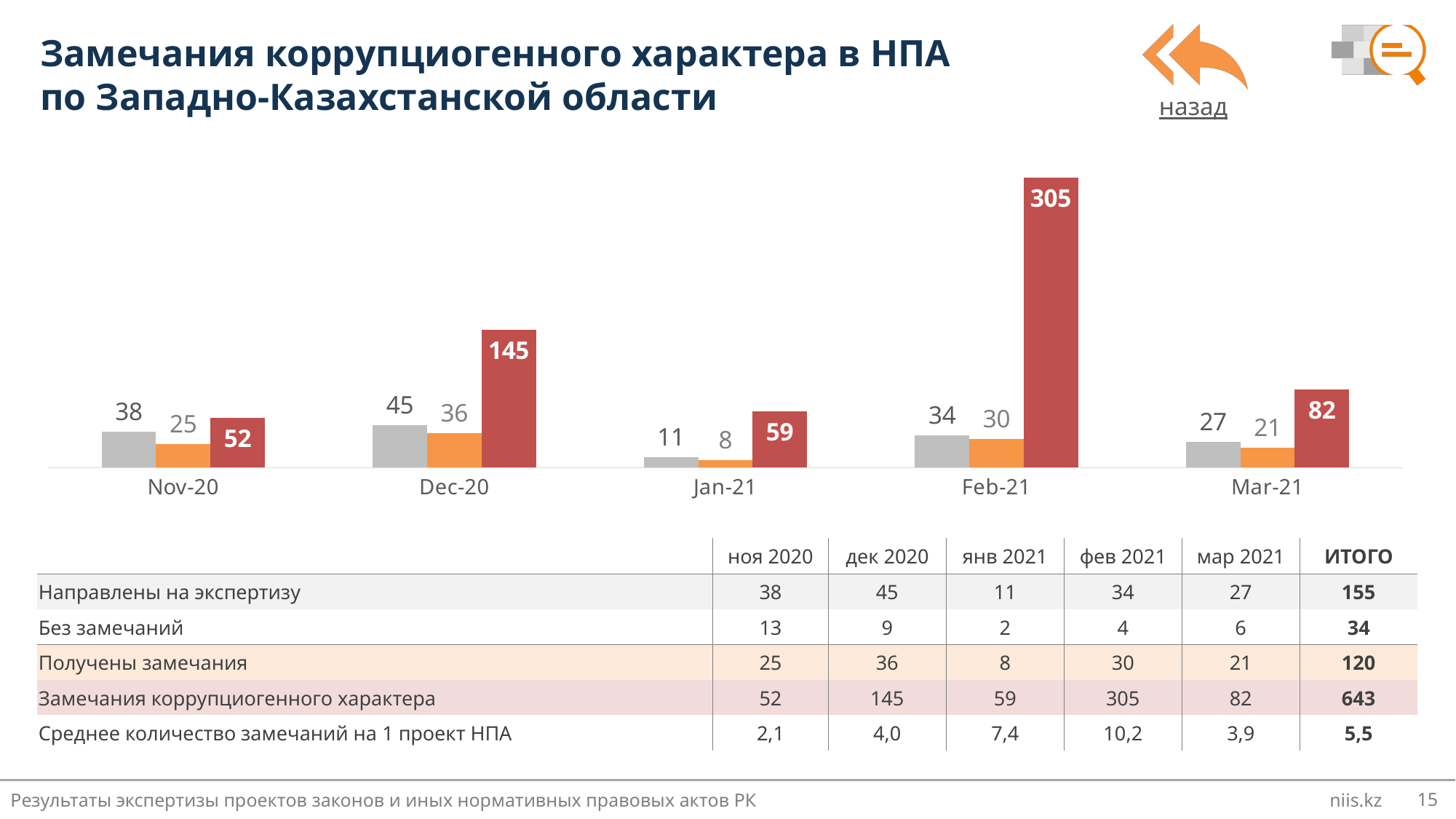
What is the value of the gray bar (Направлены на экспертизу) for Dec-20? 45 What colour are the bars representing Замечания коррупциогенного характера in the chart? red What is the value of the red bar (Замечания коррупциогенного характера) for Feb-21? 305 What is the value of the orange bar (Получены замечания) for Jan-21? 8 How many months (categories) are shown on the x axis of the chart? 5 Does the red bar (Замечания коррупциогенного характера) rise or fall from Feb-21 to Mar-21? fall What is the difference between the gray bar and the orange bar for Nov-20? 13 What is the difference between the red bar values for Feb-21 and Dec-20? 160 Which is larger: the red bar for Mar-21 or the red bar for Jan-21? Mar-21 What type of chart is shown on the slide? bar chart In which month is the red bar (Замечания коррупциогенного характера) the highest? Feb-21 In which month is the gray bar (Направлены на экспертизу) the lowest? Jan-21